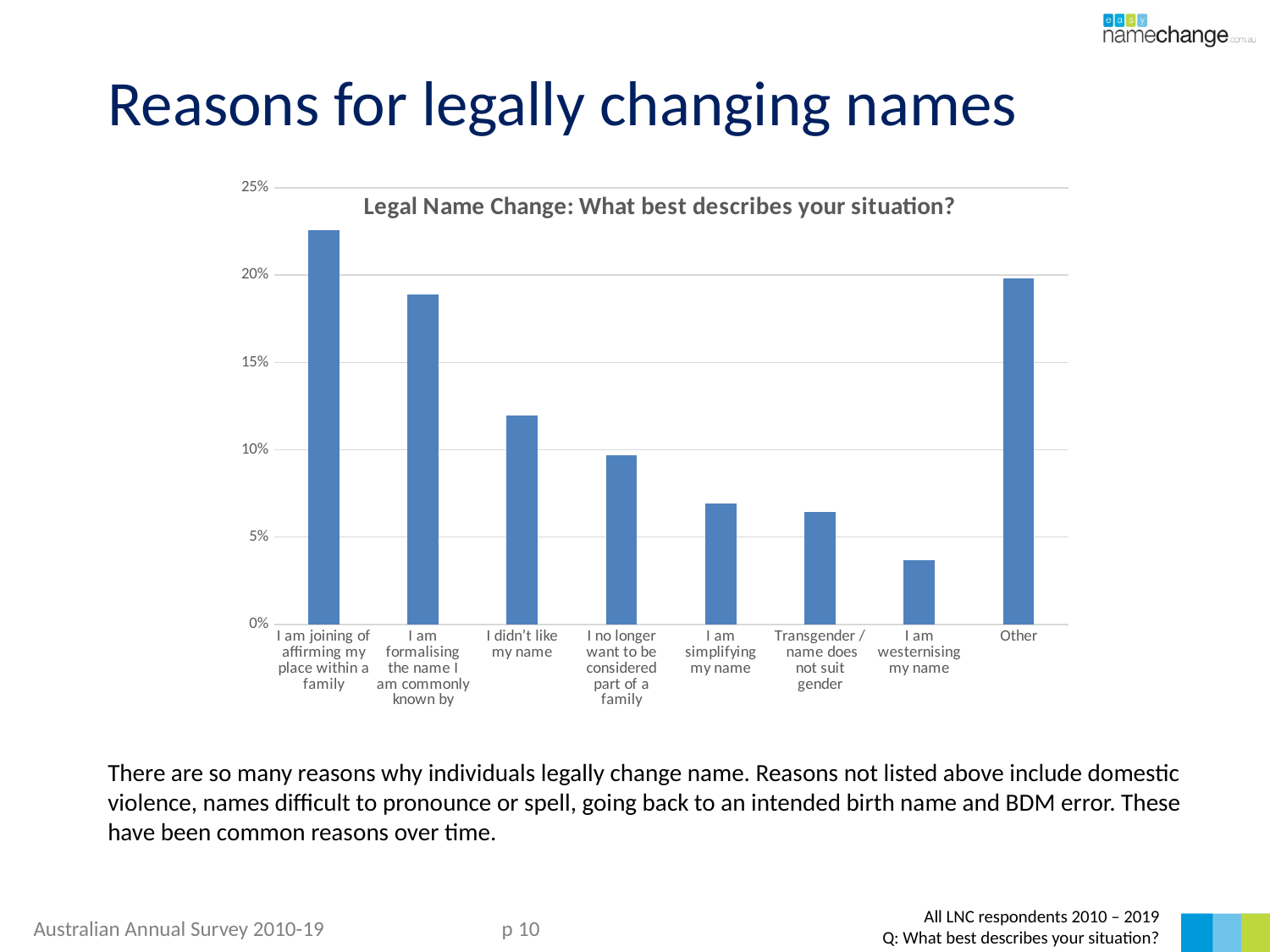
How many categories are shown on the x axis of the chart? 8 What type of chart is shown on the slide? Bar chart Which has a larger value: "I didn't like my name" or "I no longer want to be considered part of a family"? I didn't like my name Is the value for "I didn't like my name" greater or less than 10%? greater Which category has the highest value in the chart? I am joining of affirming my place within a family Is the value for "I am formalising the name I am commonly known by" greater or less than 20%? less What is the title of the chart? Legal Name Change: What best describes your situation? Is the value for "I am westernising my name" greater or less than 5%? less Which category has the lowest value in the chart? I am westernising my name